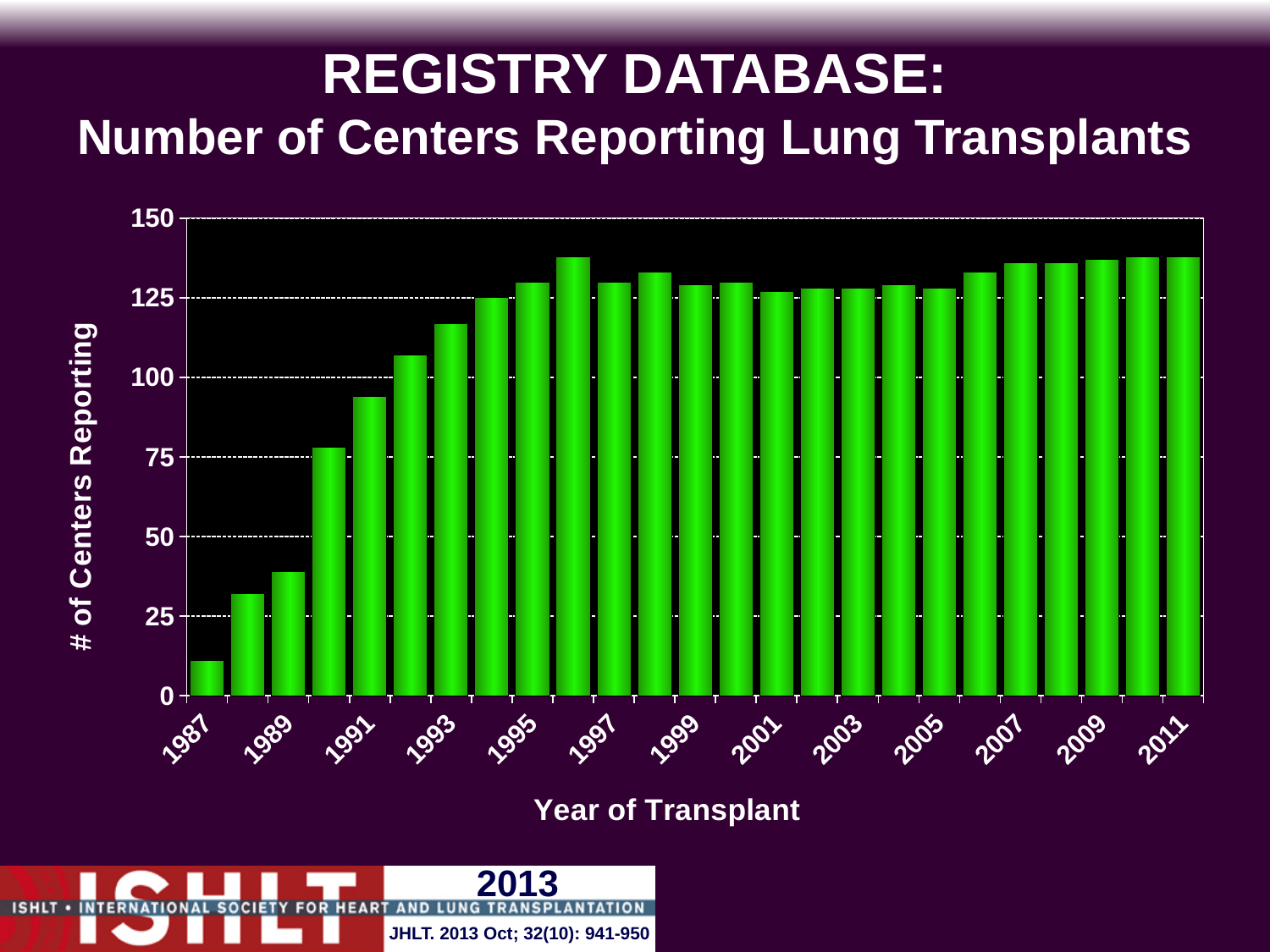
Is the value for 1987 greater or less than 25? less Is the value for 1990 greater or less than 75? greater Which year has more centers reporting, 1991 or 1996? 1996 Is the value for 1989 greater or less than 50? less Do the values generally rise or fall from 1987 to 1996? rise What is the label on the vertical axis of the chart? # of Centers Reporting Which year has the lowest number of centers reporting? 1987 How many bars (years) are plotted in the chart? 25 What kind of chart is shown on the slide? bar chart Which year has more centers reporting, 1987 or 1990? 1990